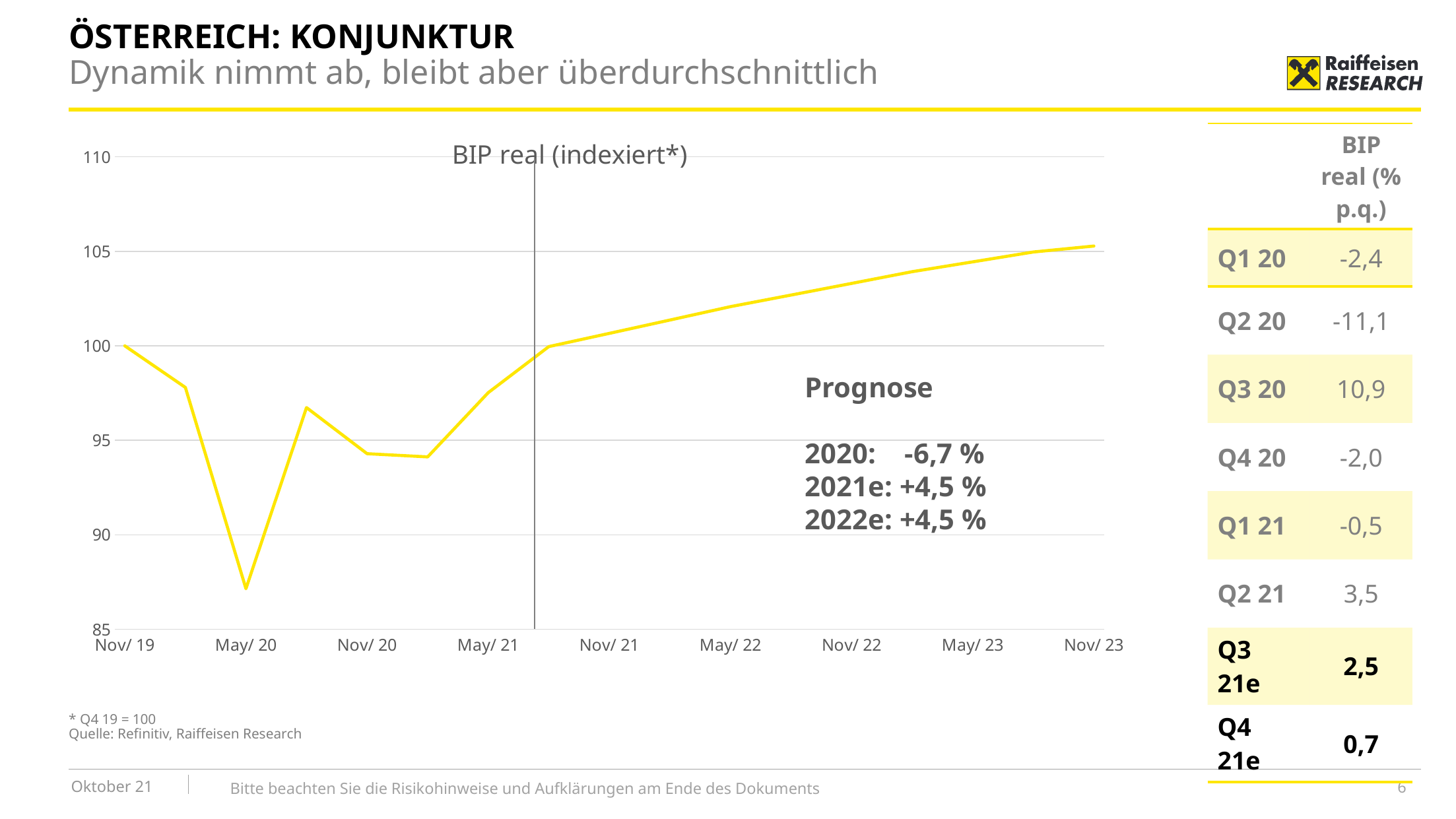
Is the value of the line at Nov/ 20 greater or less than 95? less Does the line rise or fall between Nov/ 21 and Nov/ 23? rise Is the value of the line at Nov/ 23 greater or less than 105? greater Is the value of the line at May/ 21 greater or less than 95? greater What is the value of the line at Nov/ 19? 100 What kind of chart is shown on the slide? line chart What is the title of the chart? BIP real (indexiert*) Around which x-axis label does the line reach its lowest point? May/ 20 At which x-axis label does the line reach its highest value? Nov/ 23 Which is larger, the value at Nov/ 19 or the value at May/ 20? Nov/ 19